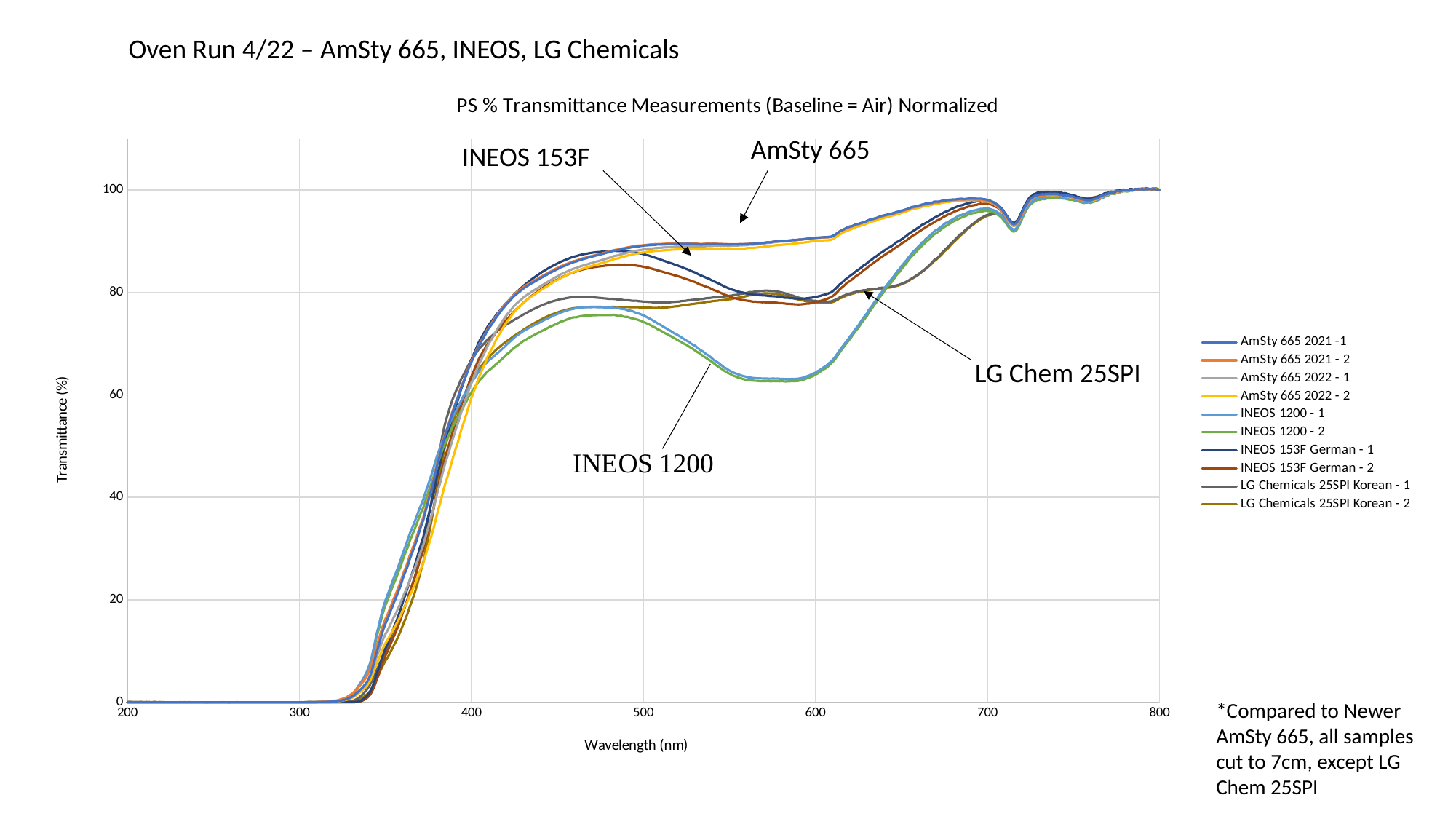
Do the transmittance values rise or fall between 300 nm and 400 nm? Rise What kind of chart is shown on the slide? Line chart How many series does the legend list? 10 Is the transmittance of AmSty 665 at 500 nm greater or less than 80? greater At 600 nm, which has the higher transmittance: AmSty 665 or INEOS 1200? AmSty 665 What is the title of the chart? PS % Transmittance Measurements (Baseline = Air) Normalized Is the transmittance of INEOS 1200 at 600 nm greater or less than 80? less Which annotated material has the lowest transmittance at around 580 nm? INEOS 1200 Is the transmittance of the samples at 300 nm greater or less than 20? less Which annotated material has the highest transmittance at 600 nm? AmSty 665 What is the label of the x axis? Wavelength (nm)